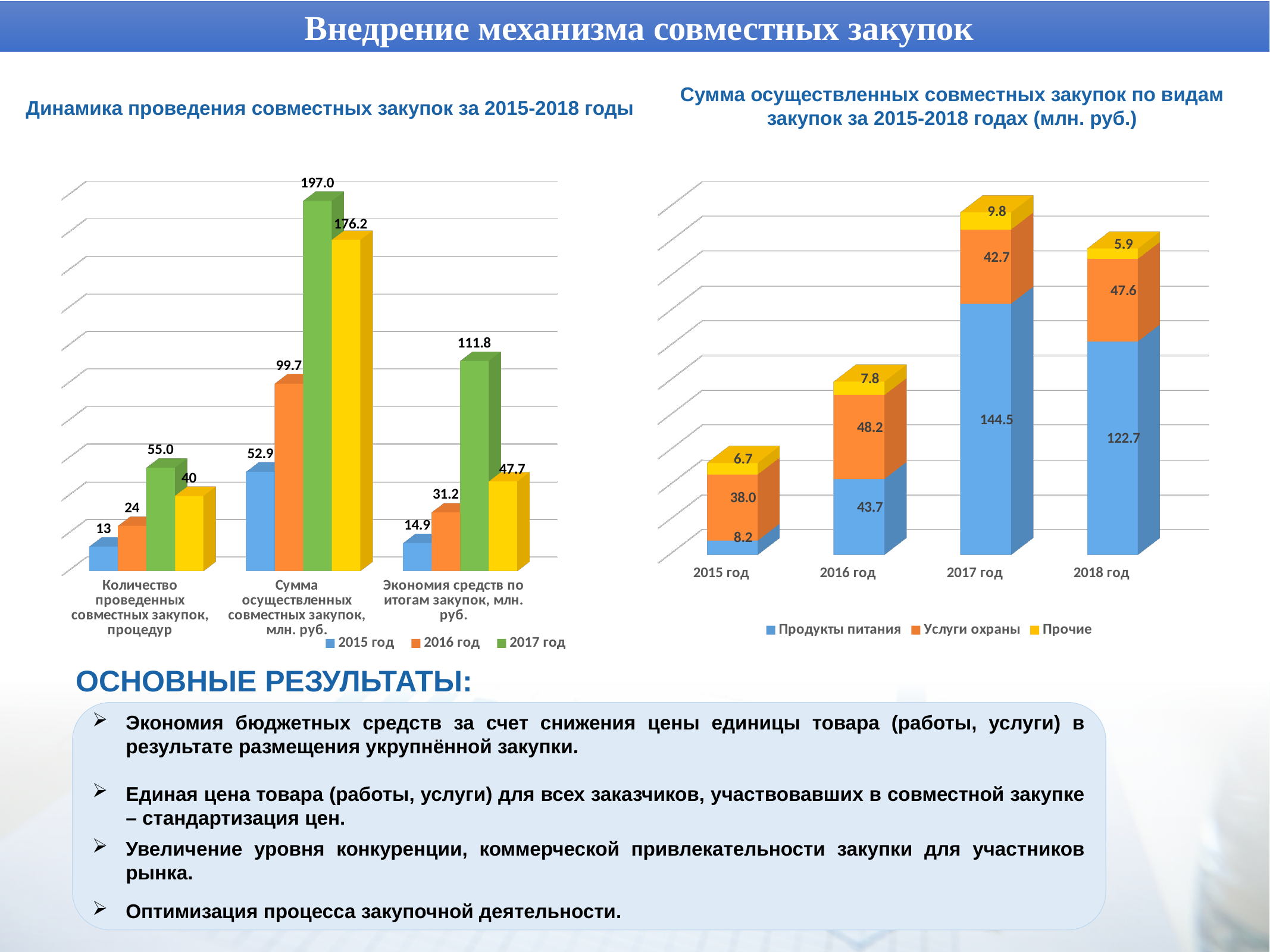
In the right chart 'Сумма осуществленных совместных закупок по видам закупок', what is the total of the stacked bar for 2016 год? 99.7 In the left chart 'Динамика проведения совместных закупок за 2015-2018 годы', what is the value for 2015 год in the category 'Количество проведенных совместных закупок, процедур'? 13 In the right chart 'Сумма осуществленных совместных закупок по видам закупок', what is the value for Продукты питания in 2017 год? 144.5 In the left chart 'Динамика проведения совместных закупок за 2015-2018 годы', how many categories are shown on the x axis? 3 In the right chart 'Сумма осуществленных совместных закупок по видам закупок', which is larger: Продукты питания in 2017 год or Продукты питания in 2018 год? 2017 год What kind of chart is the right chart 'Сумма осуществленных совместных закупок по видам закупок'? Stacked bar chart In the left chart 'Динамика проведения совместных закупок за 2015-2018 годы', how many series does the legend list? 3 In the left chart 'Динамика проведения совместных закупок за 2015-2018 годы', which year has the highest value in the category 'Экономия средств по итогам закупок, млн. руб.'? 2017 год In the left chart 'Динамика проведения совместных закупок за 2015-2018 годы', what is the difference between the 2016 год and 2015 год values in the category 'Сумма осуществленных совместных закупок, млн. руб.'? 46.8 In the left chart 'Динамика проведения совместных закупок за 2015-2018 годы', what is the value for 2017 год in the category 'Сумма осуществленных совместных закупок, млн. руб.'? 197.0 In the right chart 'Сумма осуществленных совместных закупок по видам закупок', which year has the lowest value for Прочие? 2018 год In the right chart 'Сумма осуществленных совместных закупок по видам закупок', what is the value for Услуги охраны in 2015 год? 38.0